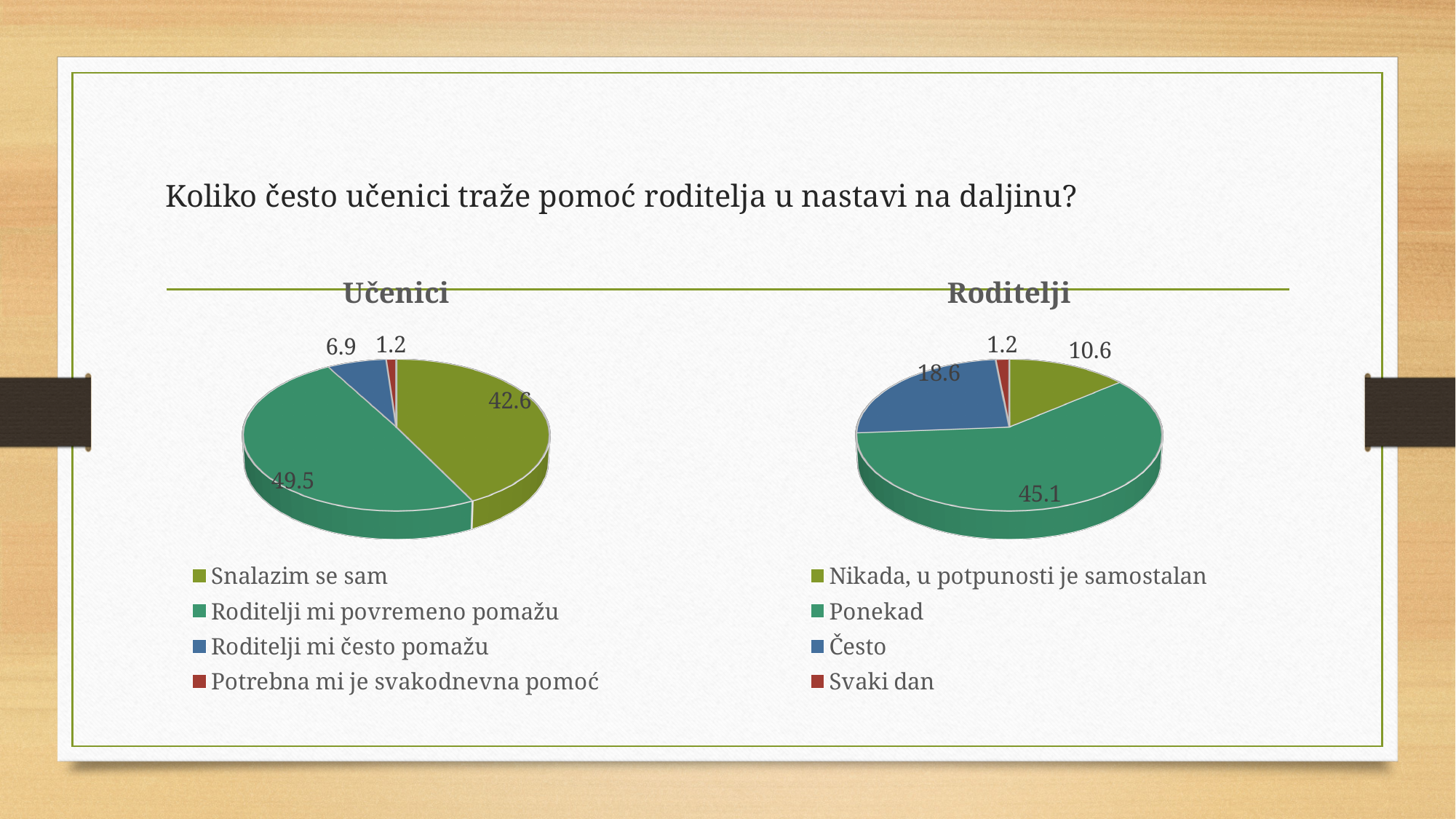
In the Učenici chart, which category has the smallest slice? Potrebna mi je svakodnevna pomoć In the Roditelji chart, which category has the largest slice? Ponekad In the Roditelji chart, what is the value for "Nikada, u potpunosti je samostalan"? 10.6 In the Roditelji chart, what is the difference between "Ponekad" and "Često"? 26.5 In the Učenici chart, what is the value for "Roditelji mi povremeno pomažu"? 49.5 In the Učenici chart, what is the value for "Snalazim se sam"? 42.6 What is the title of the chart on the left side of the slide? Učenici What type of chart is the Roditelji chart? Pie chart In the Roditelji chart, what is the value for "Često"? 18.6 In the Učenici chart, what is the difference between "Roditelji mi povremeno pomažu" and "Snalazim se sam"? 6.9 In the Roditelji chart, which is larger: "Često" or "Nikada, u potpunosti je samostalan"? Često How many categories does the Učenici chart have? 4